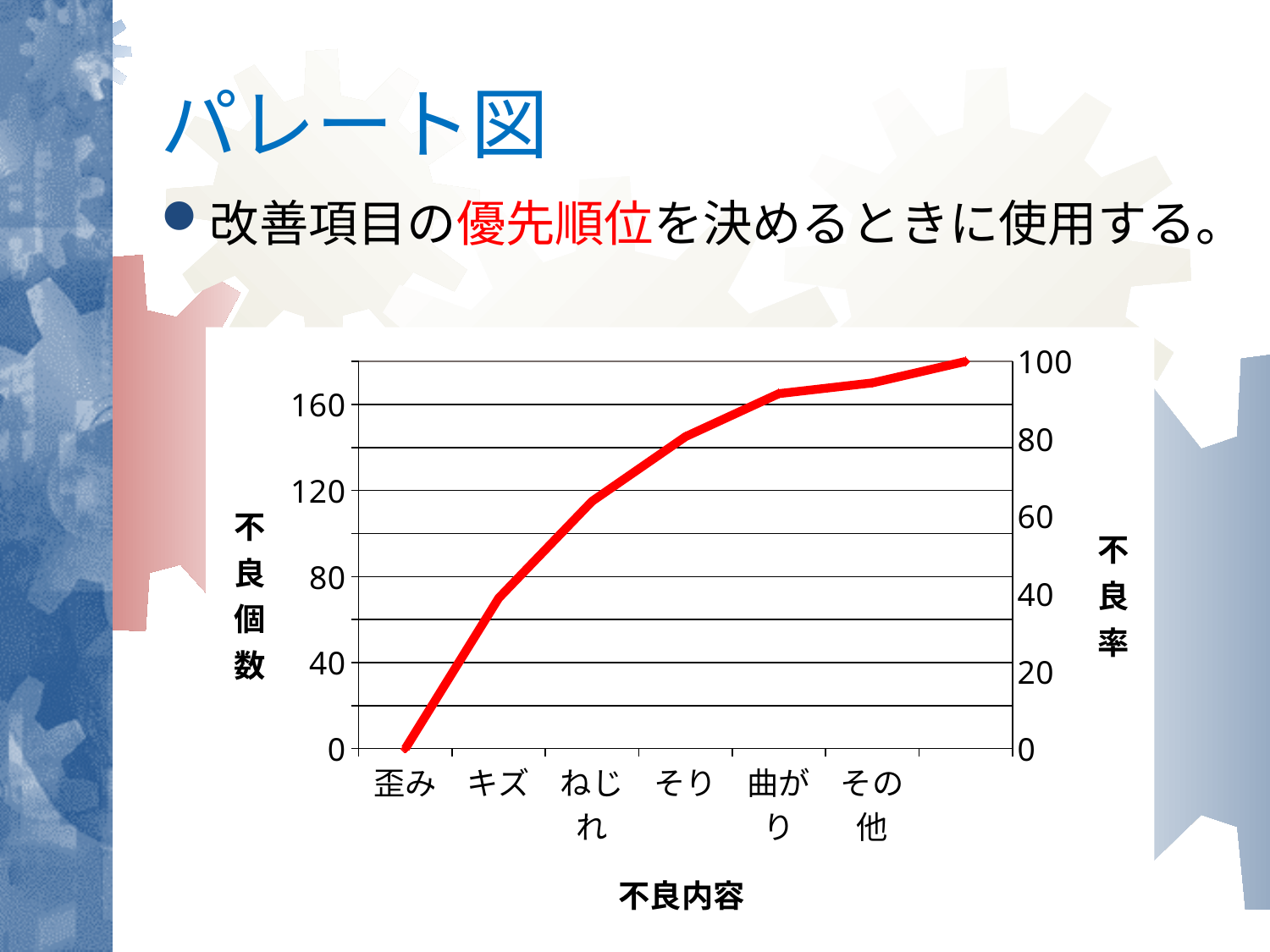
On the right-hand axis, is the value of the red line at ねじれ greater or less than 40? greater What kind of chart is shown on the slide? line chart How many categories are labelled on the x axis? 6 On the right-hand axis, is the value of the red line at そり greater or less than 60? greater On the right-hand axis, is the value of the red line at キズ greater or less than 20? greater What is the title of the x axis? 不良内容 On the right-hand axis, what is the value of the red line at 歪み? 0 Do the values of the red line rise or fall from left to right along the x axis? rise Which is larger, the value of the red line at キズ or at 曲がり? 曲がり What is the title of the right-hand vertical axis? 不良率 Which labelled category has the lowest value on the red line? 歪み